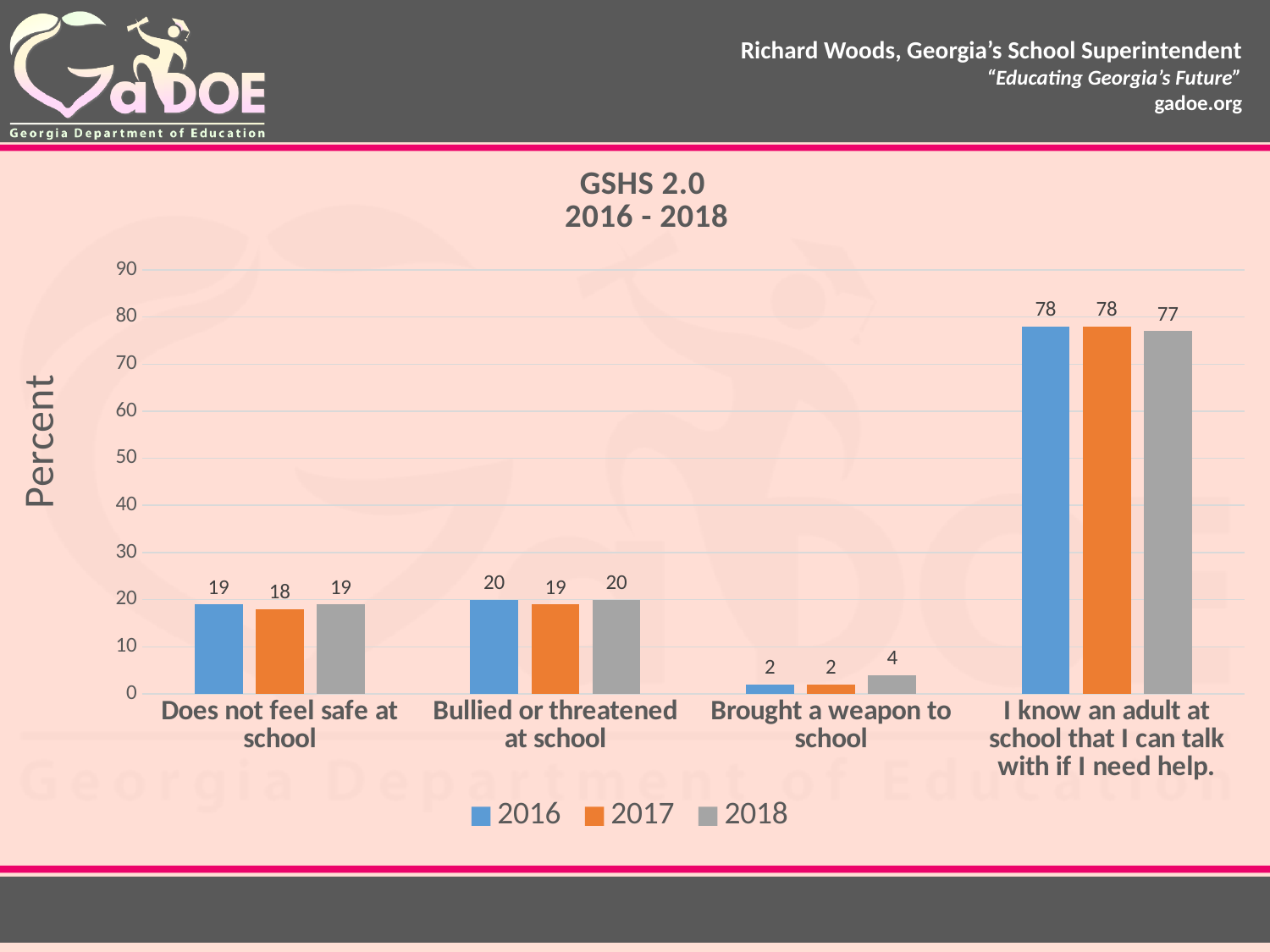
How many series does the legend list? 3 What is the difference between the 2018 and 2016 values for "Brought a weapon to school"? 2 Which is larger for "Does not feel safe at school": the 2016 value or the 2017 value? 2016 What is the 2017 value for "Bullied or threatened at school"? 19 What is the label of the y axis? Percent What is the 2017 value for "I know an adult at school that I can talk with if I need help."? 78 What is the 2016 value for "Does not feel safe at school"? 19 Which category has the lowest 2016 value? Brought a weapon to school Which category has the highest 2018 value? I know an adult at school that I can talk with if I need help. What is the 2018 value for "Brought a weapon to school"? 4 How many categories are shown on the x axis? 4 What kind of chart is shown on the slide? Bar chart